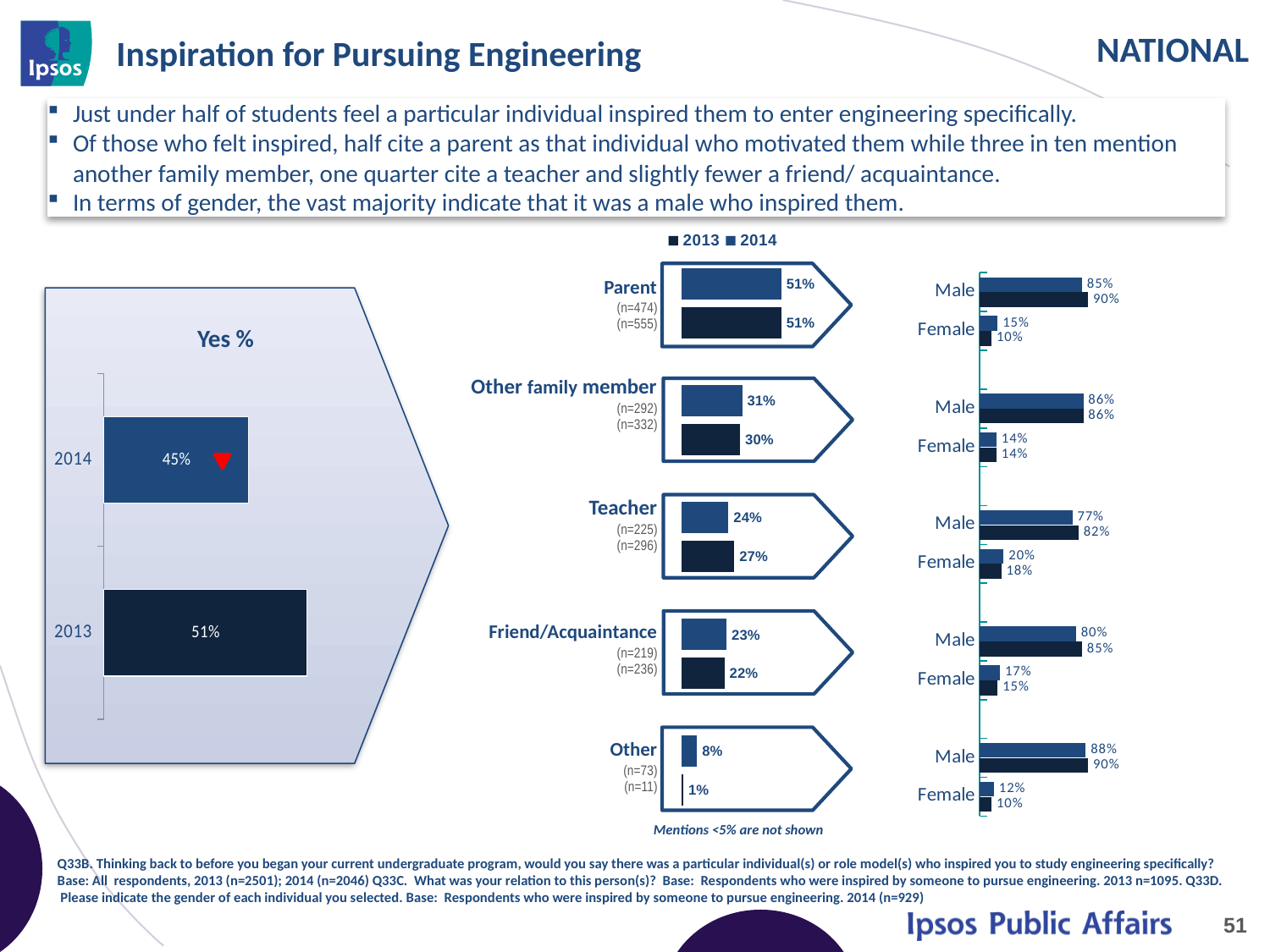
In the gender chart on the right for Teacher, what is the 2014 value for Male? 77% In the 'Yes %' chart on the left, what is the difference between the 2013 and 2014 values? 6% In the 'Yes %' chart on the left, what is the value for 2013? 51% How many series does the legend above the middle chart list? 2 In the 'Yes %' chart on the left, what is the value for 2014? 45% In the gender chart on the right for Friend/Acquaintance, is the 2013 value for Male larger or smaller than the 2014 value for Male? larger In the middle chart of relation to the inspiring person, what is the 2013 value for Other family member? 30% In the middle chart of relation to the inspiring person, which category has the lowest value in 2014? Other In the middle chart of relation to the inspiring person, which category has the highest value in 2014? Parent In the middle chart of relation to the inspiring person, how many categories are shown? 5 What type of chart is the 'Yes %' chart on the left? bar chart In the middle chart of relation to the inspiring person, what is the 2014 value for Teacher? 24%